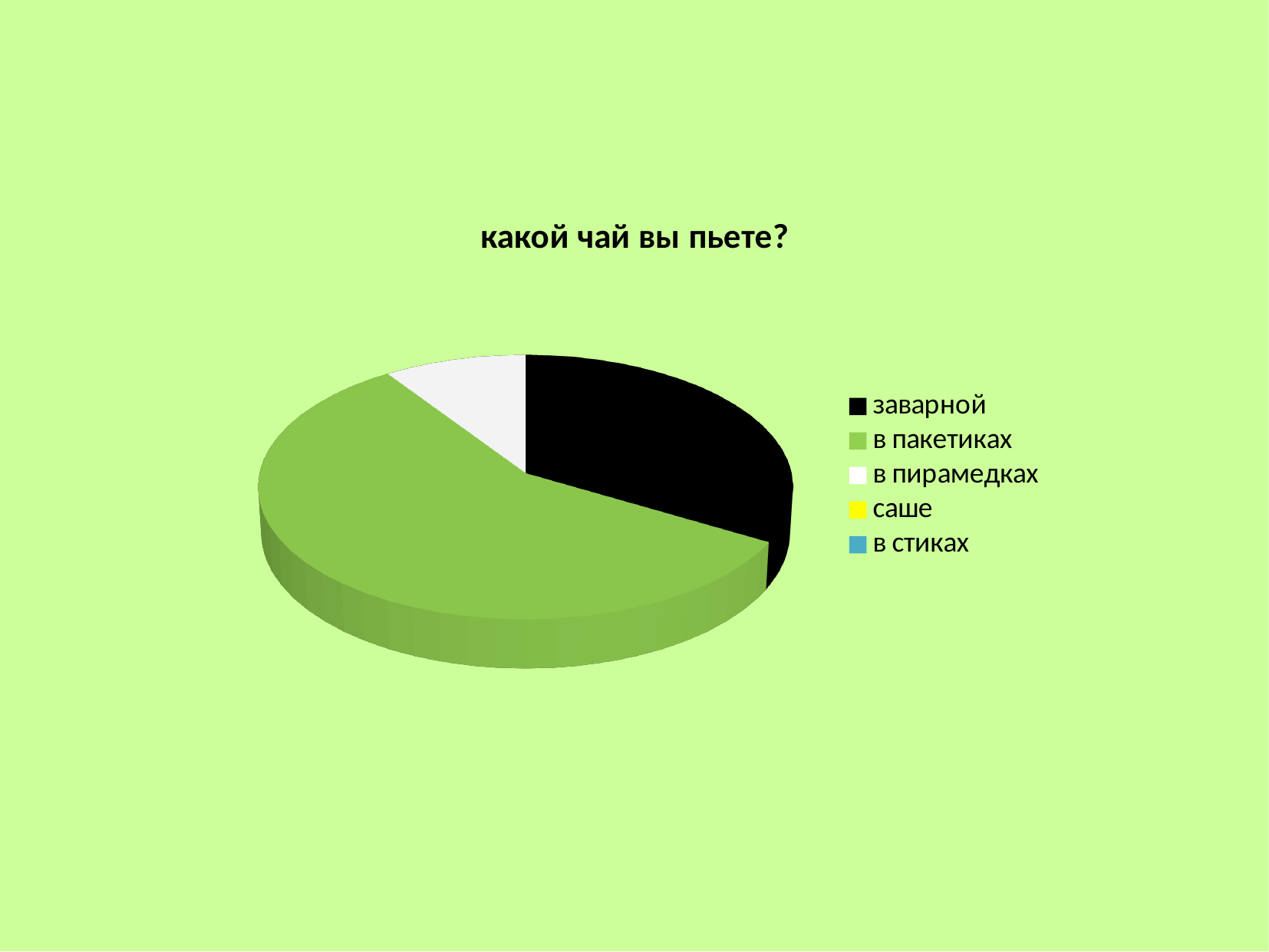
Which of the slices visible in the pie is the smallest? в пирамедках What is the title of the chart? какой чай вы пьете? What colour is the slice for заварной? black How many categories does the chart's legend list? 5 What kind of chart is shown on the slide? pie chart Which slice is larger, в пакетиках or в пирамедках? в пакетиках Which slice is larger, заварной or в пирамедках? заварной Which slice is larger, в пакетиках or заварной? в пакетиках How many slices are visibly drawn in the pie? 3 Which category has the largest slice of the pie? в пакетиках